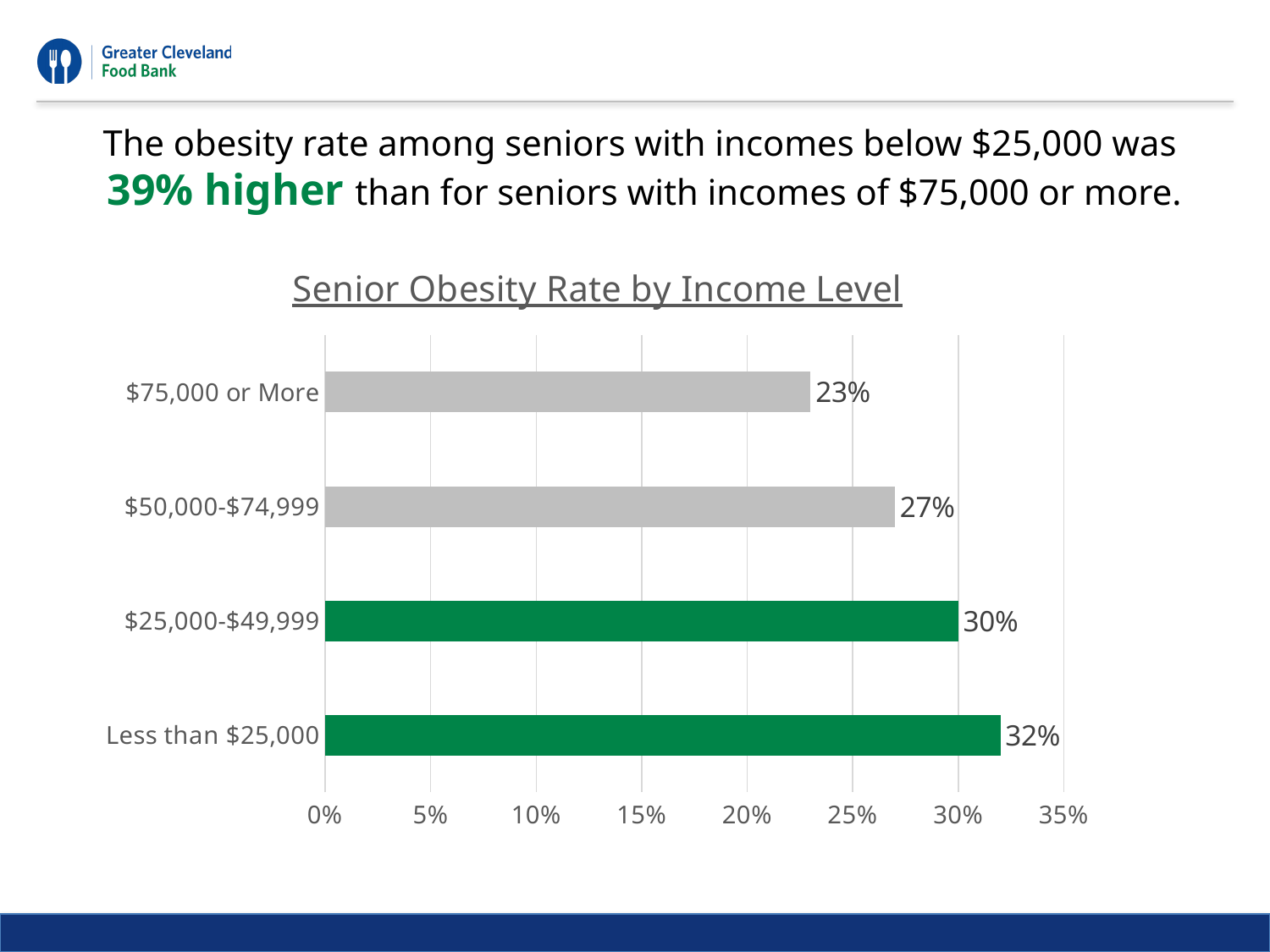
Which has a higher senior obesity rate: $50,000-$74,999 or $25,000-$49,999? $25,000-$49,999 What is the senior obesity rate for the Less than $25,000 income group? 32% How many income groups are shown in the chart? 4 Which income group has the lowest senior obesity rate? $75,000 or More Is the obesity rate for the $50,000-$74,999 group greater or less than 25%? greater What is the difference in obesity rate between the Less than $25,000 group and the $75,000 or More group? 9% What type of chart is used to show senior obesity rate by income level? Bar chart What is the senior obesity rate for the $75,000 or More income group? 23% What is the senior obesity rate for the $25,000-$49,999 income group? 30% What is the title of the chart? Senior Obesity Rate by Income Level What is the senior obesity rate for the $50,000-$74,999 income group? 27% Which income group has the highest senior obesity rate? Less than $25,000